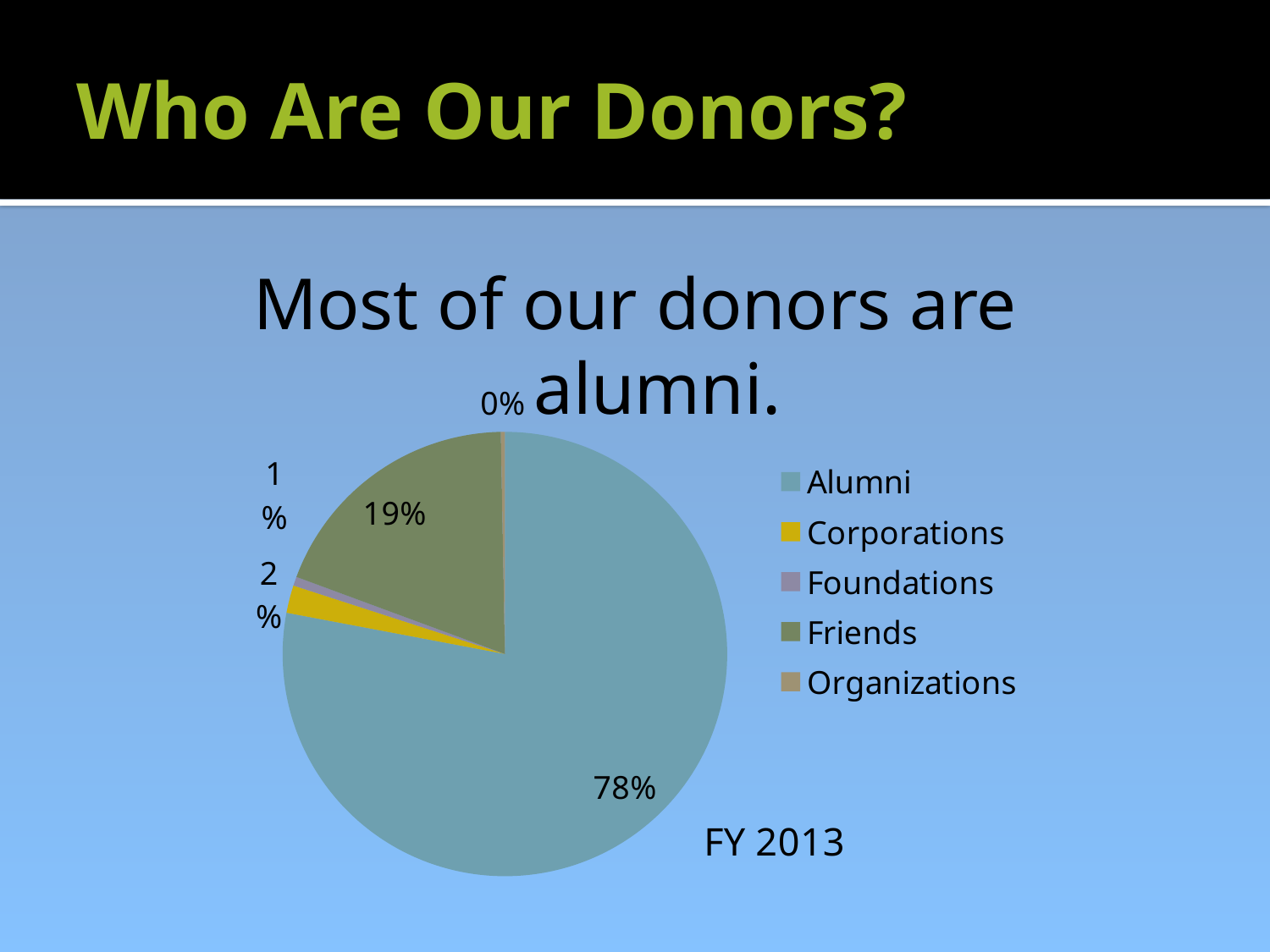
What percentage of donors are Friends? 19% Which donor category has the largest share of the pie? Alumni What percentage of donors are Foundations? 1% Which fiscal year does the pie chart cover? FY 2013 What kind of chart is shown on the slide? pie chart What percentage of donors are Corporations? 2% What percentage of donors are Organizations? 0% How many donor categories does the legend list? 5 Which donor category has the smallest share of the pie? Organizations What is the difference in percentage points between the Alumni share and the Friends share? 59 Which is larger, the share for Friends or the share for Corporations? Friends What percentage of donors are Alumni? 78%